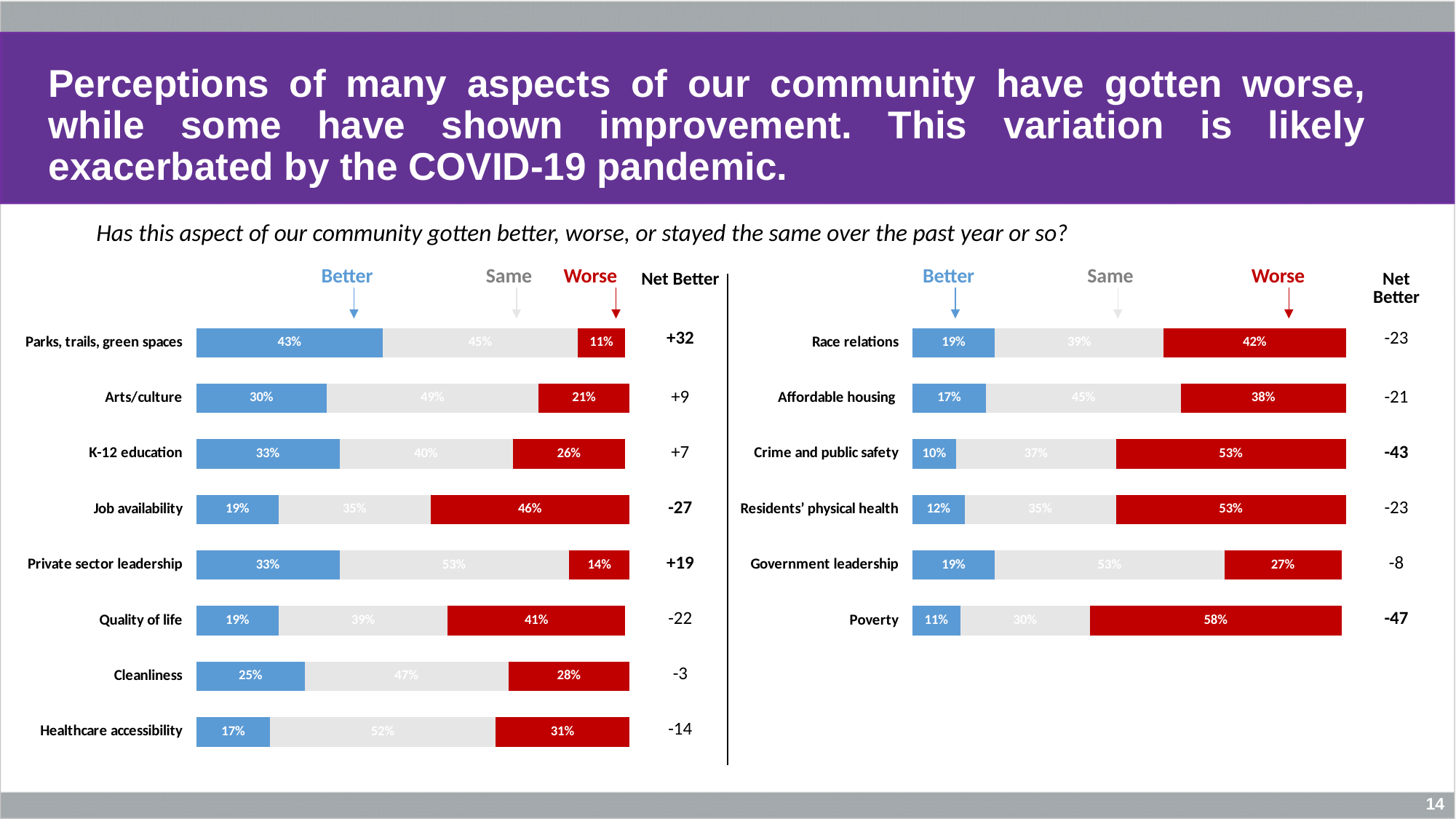
In the left chart, what percentage said parks, trails, green spaces have gotten better? 43% How many aspects are listed in the right chart? 6 How many response categories (series) does each chart show? 3 In the left chart, which aspect has the lowest 'Better' percentage? Healthcare accessibility How many aspects are listed in the left chart? 8 In the right chart, what colour represents the 'Worse' responses? Red In the right chart, which aspect has the highest 'Worse' percentage? Poverty What type of chart is used on this slide? Stacked bar chart In the right chart, which is larger: the 'Better' percentage for race relations or for affordable housing? Race relations In the left chart, what is the difference between the 'Worse' percentages for job availability and cleanliness? 18% In the right chart, what percentage said poverty has gotten worse? 58% In the left chart, what is the Net Better value for job availability? -27